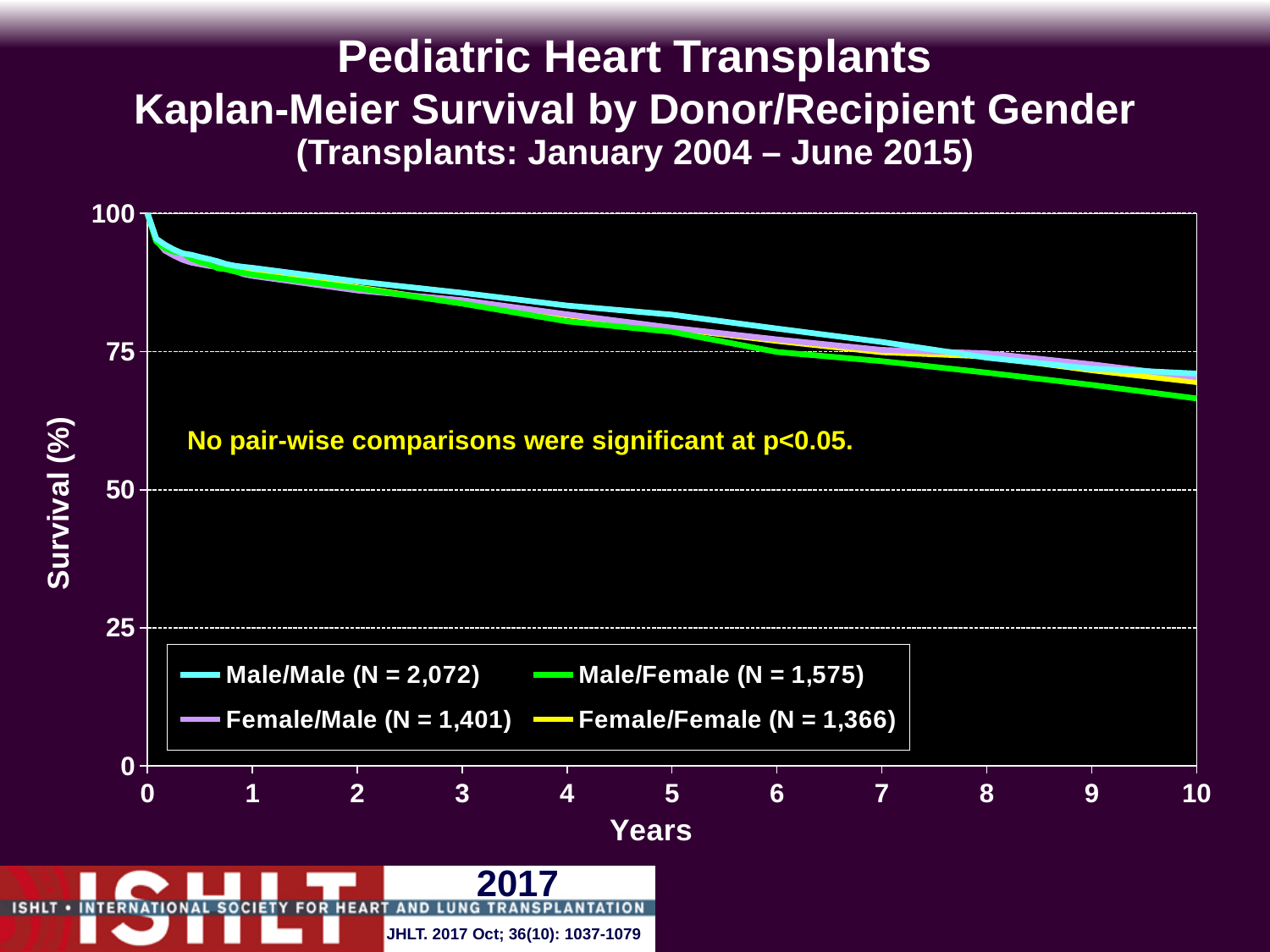
At 10 years, which is higher: the survival for Male/Male or for Male/Female? Male/Male How many series does the legend list? 4 Which series has the smallest N in the legend? Female/Female Do the survival curves rise or fall as years increase? fall What kind of chart is shown on the slide? line chart What does the annotation inside the chart say about pair-wise comparisons? No pair-wise comparisons were significant at p<0.05. What is the N for the Male/Male series in the legend? 2,072 Which series has the largest N in the legend? Male/Male Is the survival value for Male/Female at 10 years greater or less than 75? less What is the N for the Female/Female series in the legend? 1,366 Which series has the lowest survival at 10 years? Male/Female Is the survival value for Male/Male at 2 years greater or less than 75? greater